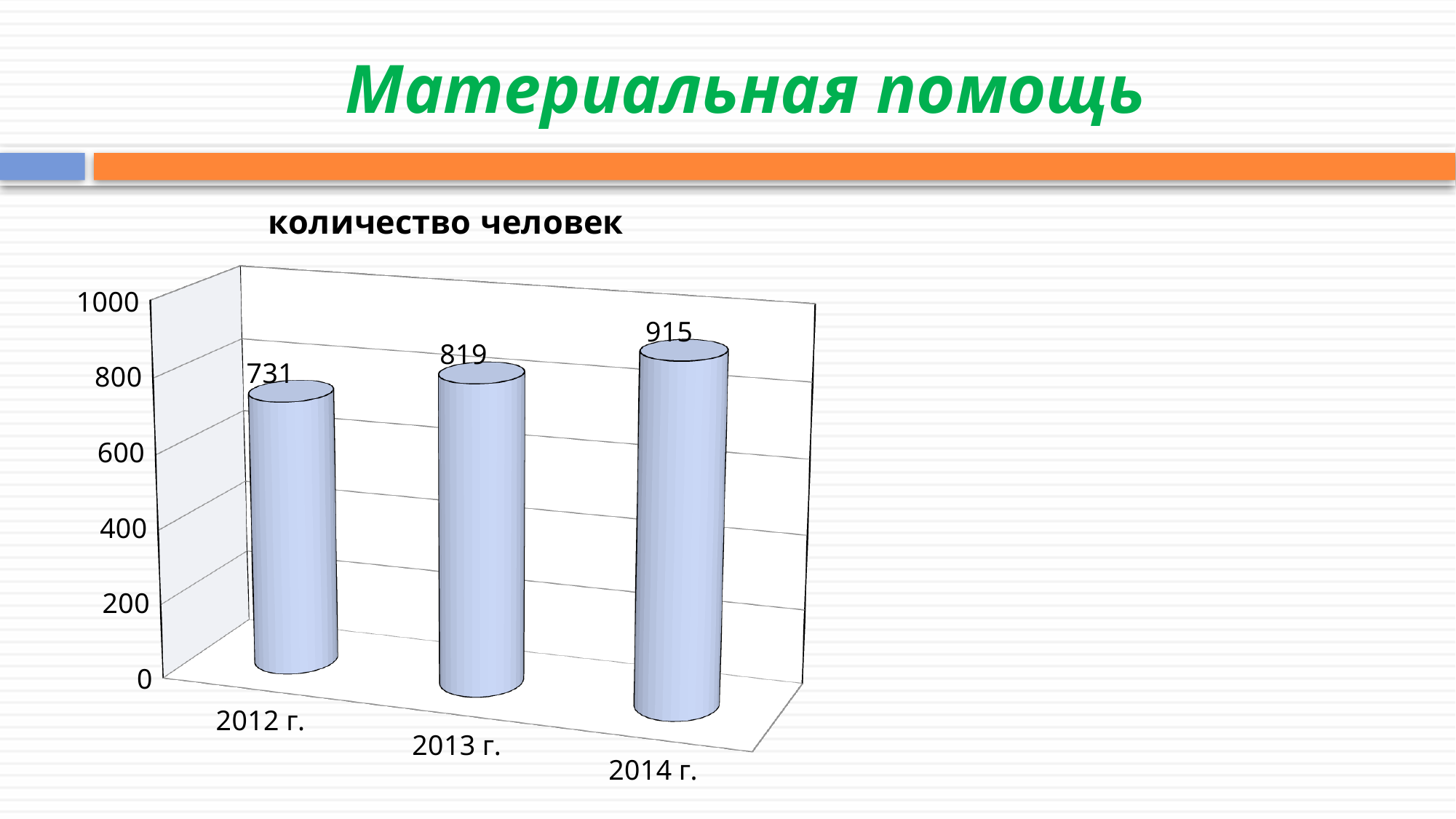
Which year has the lowest value? 2012 г. What is the value for 2013 г.? 819 What is the difference between the values for 2014 г. and 2012 г.? 184 Which is larger, the value for 2013 г. or the value for 2014 г.? 2014 г. How many years are shown on the chart? 3 What is the value for 2014 г.? 915 Is the value for 2012 г. greater or less than 800? less What is the value for 2012 г.? 731 What kind of chart is shown on the slide? bar chart Which year has the highest value? 2014 г. Do the values rise or fall from 2012 г. to 2014 г.? rise What is the difference between the values for 2013 г. and 2012 г.? 88